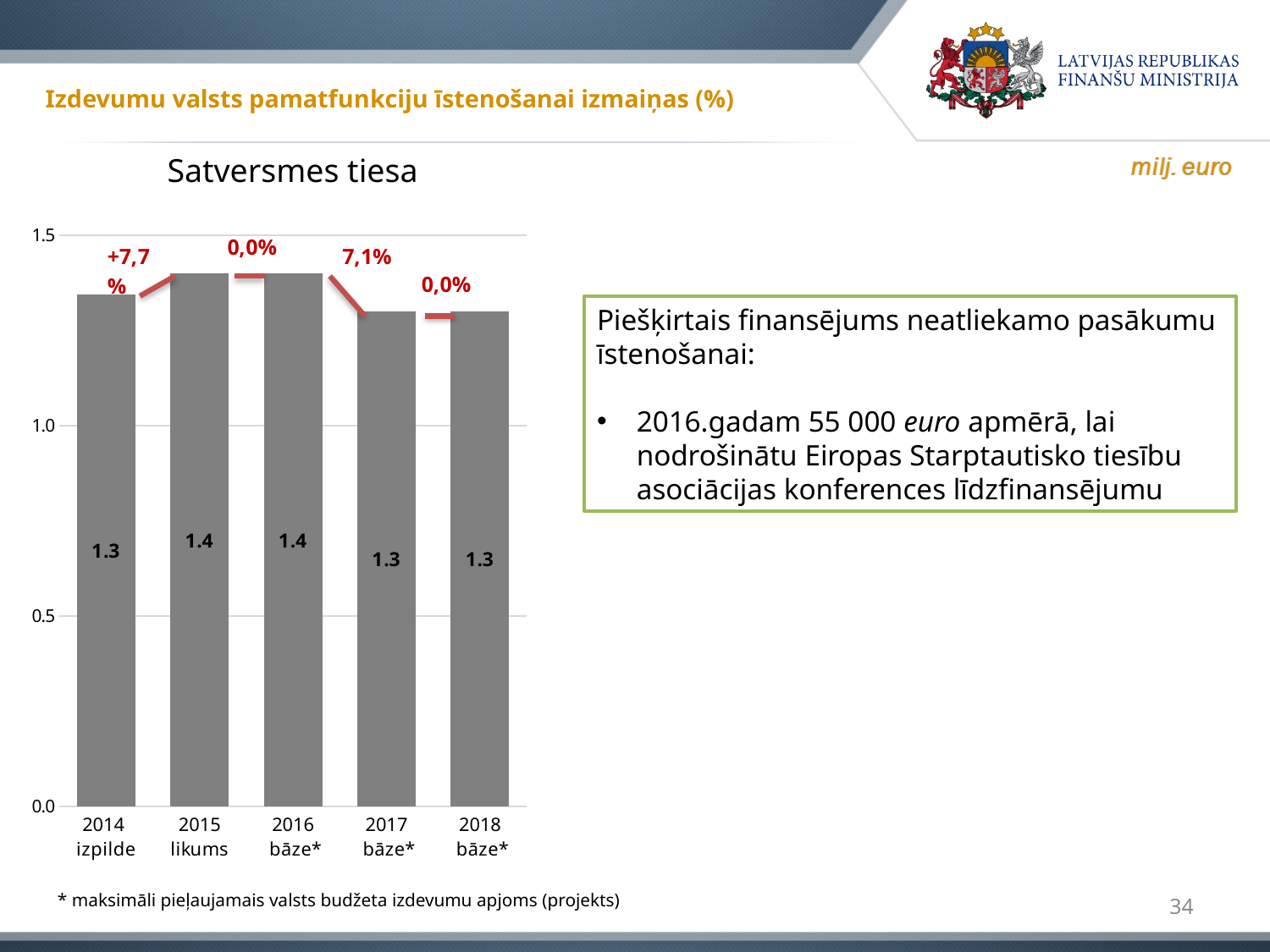
What kind of chart is shown on the slide? bar chart Is the value for 2014 izpilde greater or less than 1.0? greater What is the difference between the values for 2015 likums and 2014 izpilde? 0.1 What is the value for 2017 bāze*? 1.3 What is the value for 2014 izpilde? 1.3 Does the value rise or fall from 2016 bāze* to 2017 bāze*? fall What is the title of the chart? Satversmes tiesa What percentage change is labelled between 2014 izpilde and 2015 likums? +7,7% Which is larger, the value for 2016 bāze* or the value for 2017 bāze*? 2016 bāze* What is the value for 2018 bāze*? 1.3 How many categories are shown on the x axis? 5 What is the value for 2015 likums? 1.4